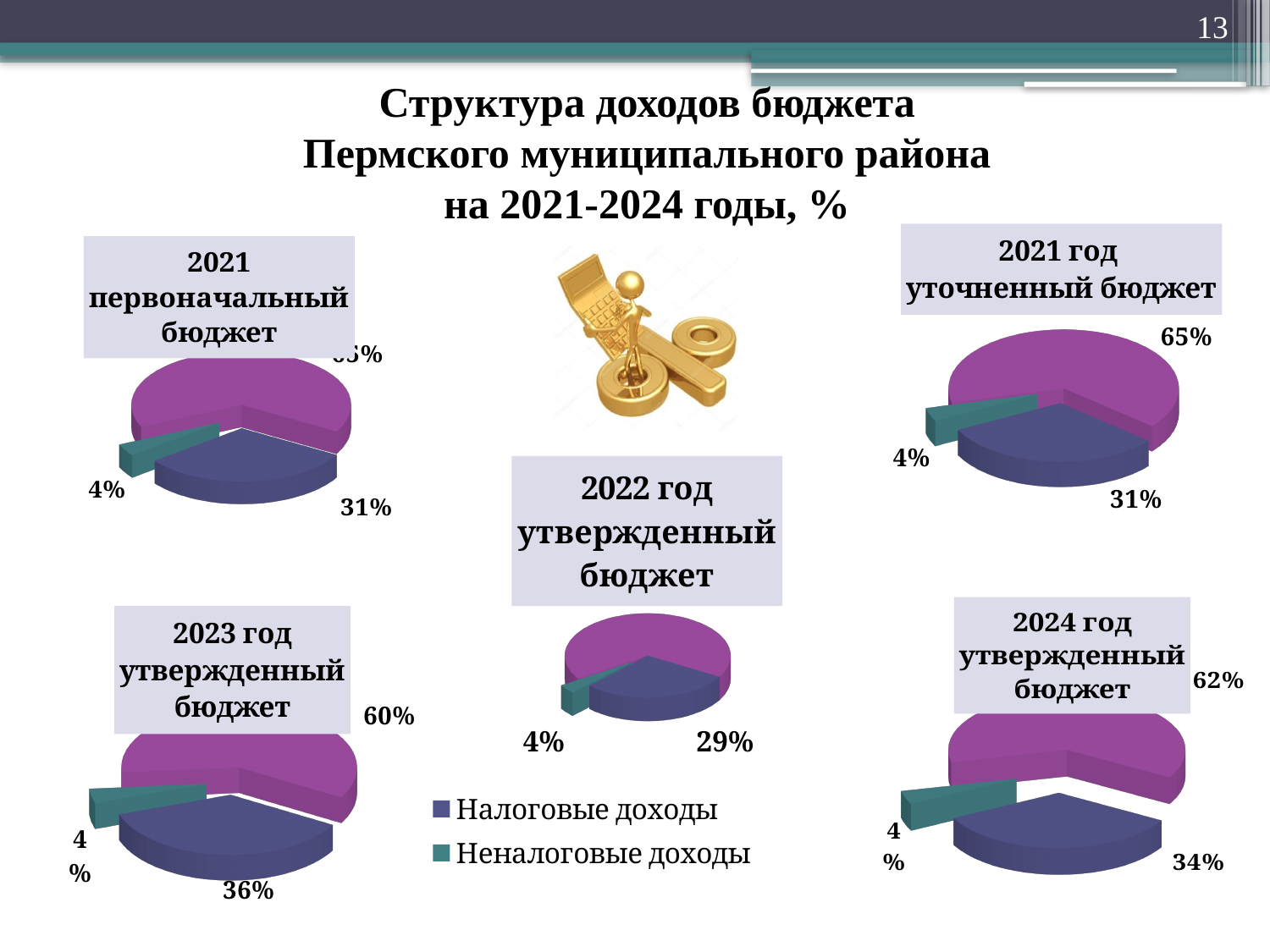
On the '2023 год утвержденный бюджет' pie chart, what percentage is shown for Неналоговые доходы? 4% On the '2022 год утвержденный бюджет' pie chart, what percentage is shown for Налоговые доходы? 29% How many pie charts are shown on the slide? 5 On the '2021 первоначальный бюджет' pie chart, what percentage is shown for Налоговые доходы? 31% What type of chart is used on this slide? Pie chart On the '2024 год утвержденный бюджет' pie chart, what percentage is shown for Налоговые доходы? 34% On the '2023 год утвержденный бюджет' pie chart, by how many percentage points does Налоговые доходы exceed Неналоговые доходы? 32 On the '2021 год уточненный бюджет' pie chart, what percentage is shown for Налоговые доходы? 31% How many entries does the legend on the slide list? 2 What is the largest percentage labelled on the '2021 год уточненный бюджет' pie chart? 65% On the '2022 год утвержденный бюджет' chart, which is larger: Налоговые доходы or Неналоговые доходы? Налоговые доходы Which chart shows a larger share for Налоговые доходы: '2023 год утвержденный бюджет' or '2024 год утвержденный бюджет'? 2023 год утвержденный бюджет